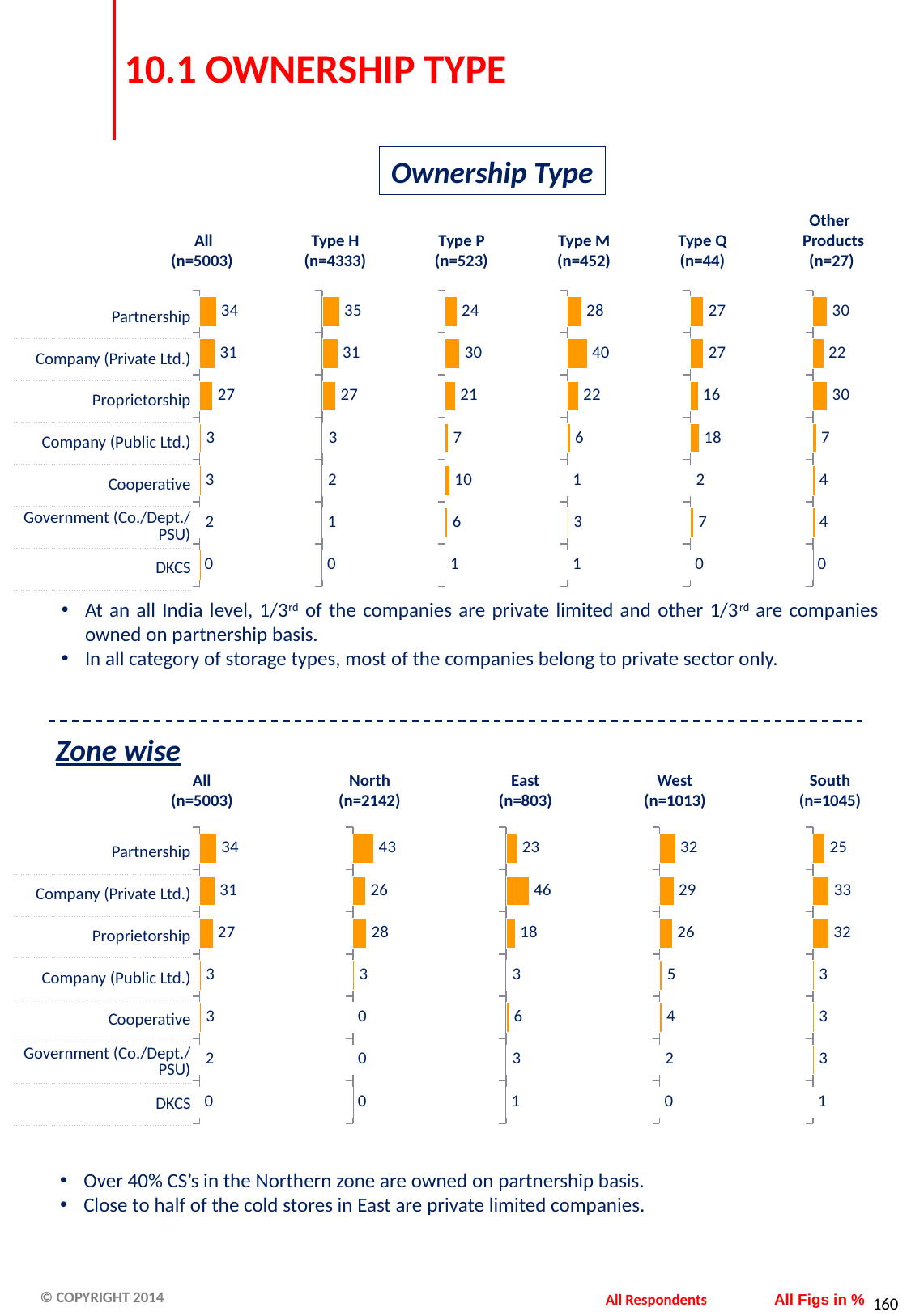
In the Ownership Type chart at the top, which ownership category has the highest value under Type Q (n=44)? Partnership and Company (Private Ltd.) (both 27) In the Ownership Type chart at the top, what is the difference between Partnership and Proprietorship under Type H (n=4333)? 8 In the Ownership Type chart at the top, which is larger under Type P (n=523): Cooperative or Company (Public Ltd.)? Cooperative What kind of chart is used in the Zone wise section at the bottom of the slide? Bar chart In the Zone wise chart at the bottom, what is the difference between Company (Private Ltd.) and Proprietorship under South (n=1045)? 1 In the Ownership Type chart at the top, what is the value for Company (Private Ltd.) under Type M (n=452)? 40 In the Zone wise chart at the bottom, what is the value for Partnership under North (n=2142)? 43 In the Ownership Type chart at the top, what is the value for Partnership in the All (n=5003) column? 34 In the Zone wise chart at the bottom, how many zone columns are shown in addition to All? 4 In the Zone wise chart at the bottom, which is larger under West (n=1013): Partnership or Company (Private Ltd.)? Partnership In the Zone wise chart at the bottom, which ownership category has the highest value under East (n=803)? Company (Private Ltd.) In the Ownership Type chart at the top, how many ownership categories are listed? 7